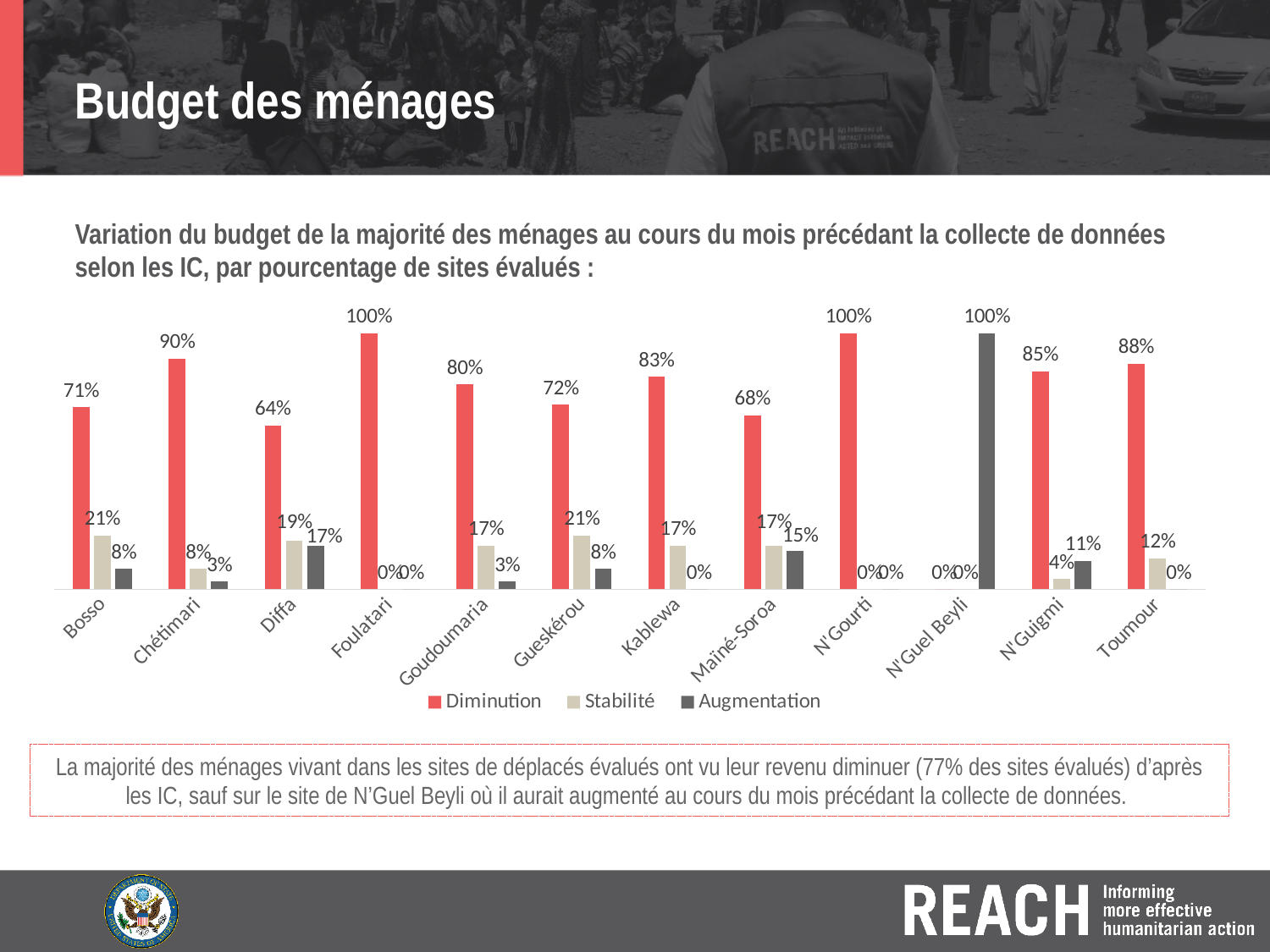
What is the Augmentation value for N'Guel Beyli? 100% Which colour represents the Diminution series in the legend? Red What is the Stabilité value for Diffa? 19% Which is larger, the Diminution value for Goudoumaria or for Kablewa? Kablewa Which category has the lowest Diminution value? N'Guel Beyli How many categories are shown on the x axis? 12 What is the Diminution value for Bosso? 71% What is the Augmentation value for Maïné-Soroa? 15% How many series does the legend list? 3 Which category has the highest Augmentation value? N'Guel Beyli What is the difference between the Diminution values for Chétimari and Diffa? 26% What kind of chart is shown on the slide? Bar chart